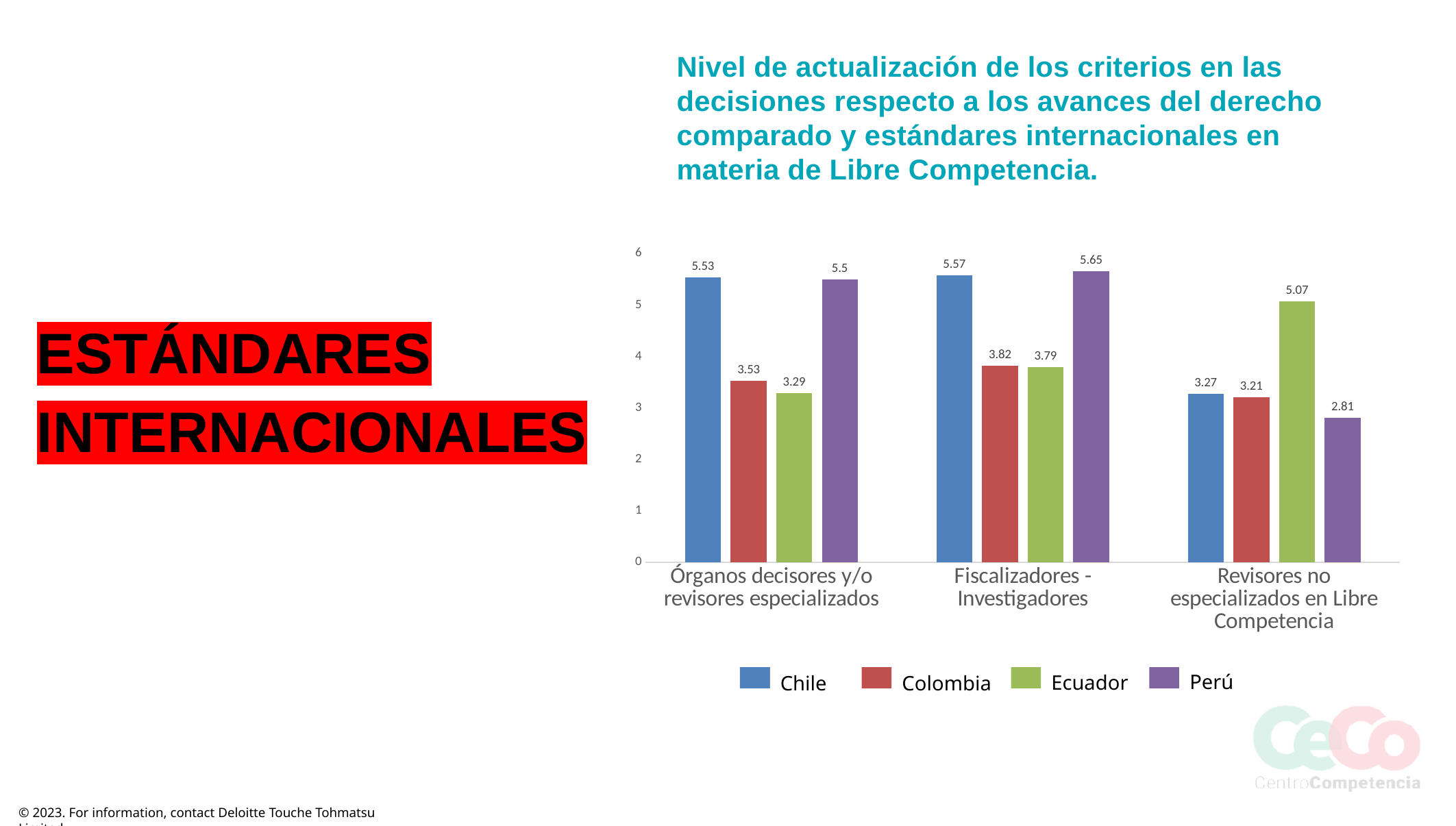
How many categories are shown on the x axis? 3 What is the value for Perú in the 'Fiscalizadores - Investigadores' category? 5.65 What is the value for Chile in the 'Órganos decisores y/o revisores especializados' category? 5.53 What is the difference between the Chile and Colombia values in the 'Órganos decisores y/o revisores especializados' category? 2 How many series does the legend list? 4 Which colour represents Ecuador in the legend? Green Which country has the lowest value in the 'Revisores no especializados en Libre Competencia' category? Perú What is the value for Ecuador in the 'Revisores no especializados en Libre Competencia' category? 5.07 What kind of chart is shown on the slide? Bar chart Which is larger in the 'Fiscalizadores - Investigadores' category: Colombia or Ecuador? Colombia Which country has the highest value in the 'Fiscalizadores - Investigadores' category? Perú Is the value for Perú in the 'Revisores no especializados en Libre Competencia' category greater or less than 3? less